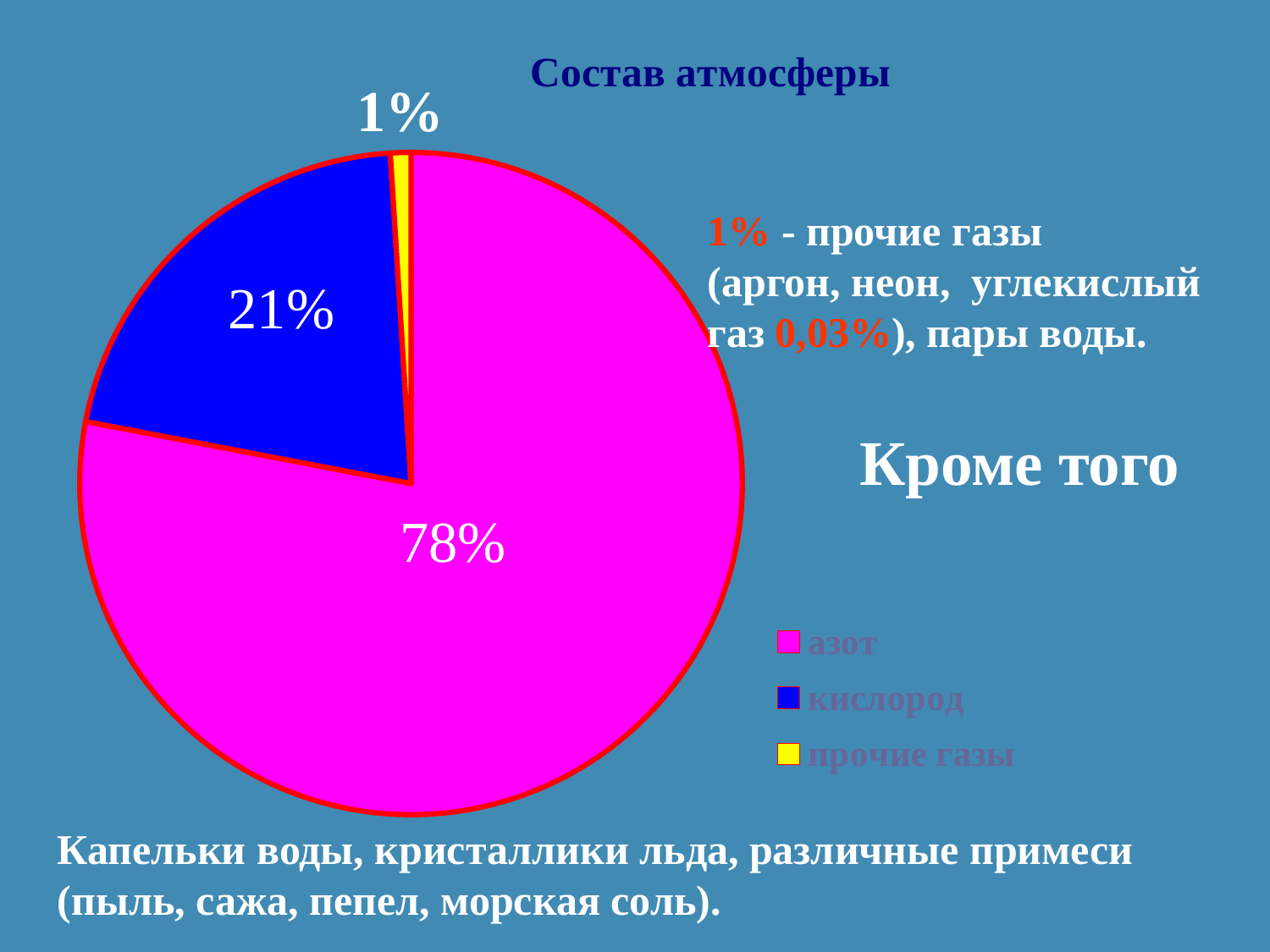
What is the title of the chart? Состав атмосферы Which slice of the pie chart is the largest? азот What kind of chart is shown on the slide? pie chart How many slices does the pie chart have? 3 What is the share of азот (nitrogen) in the pie chart? 78% What colour is the slice for кислород? blue How many entries does the legend list? 3 What is the difference in percentage points between азот and кислород? 57 What is the share of кислород (oxygen) in the pie chart? 21% Which slice of the pie chart is the smallest? прочие газы What is the share of прочие газы (other gases) in the pie chart? 1% Which is larger, the share of кислород or the share of прочие газы? кислород